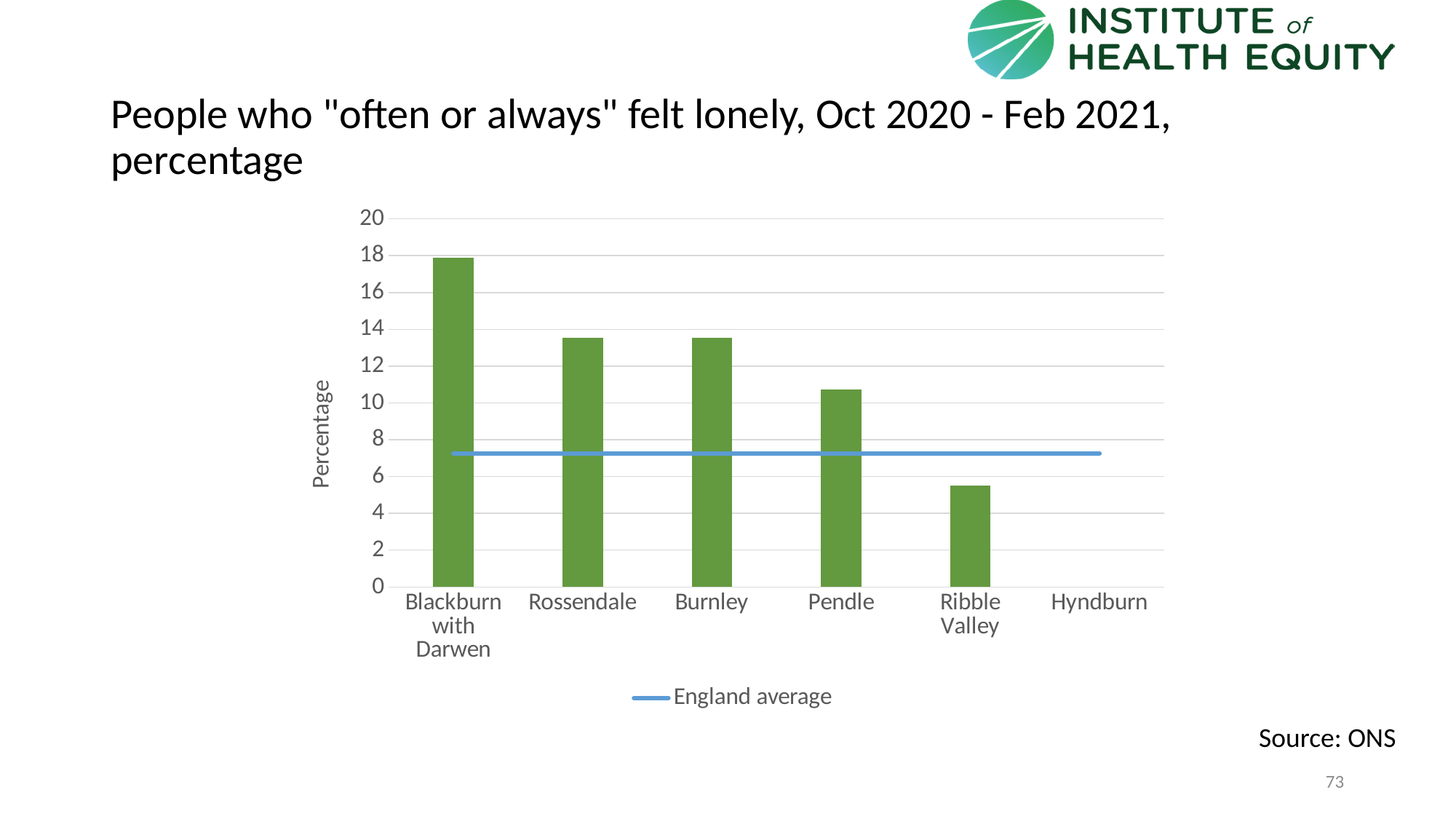
Which area has the highest percentage of people who often or always felt lonely? Blackburn with Darwen Is the bar for Ribble Valley above or below the England average line? below Which area with a plotted bar has the lowest percentage? Ribble Valley Which is larger, the value for Blackburn with Darwen or the value for Pendle? Blackburn with Darwen How many areas are labelled on the x axis? 6 How many series does the legend list? 1 What kind of chart is shown on the slide? Combination bar and line chart (bars with an England average line) Is the value for Rossendale greater or less than 12? greater Is the value for Blackburn with Darwen greater or less than 16? greater Is the England average line greater or less than 8? less